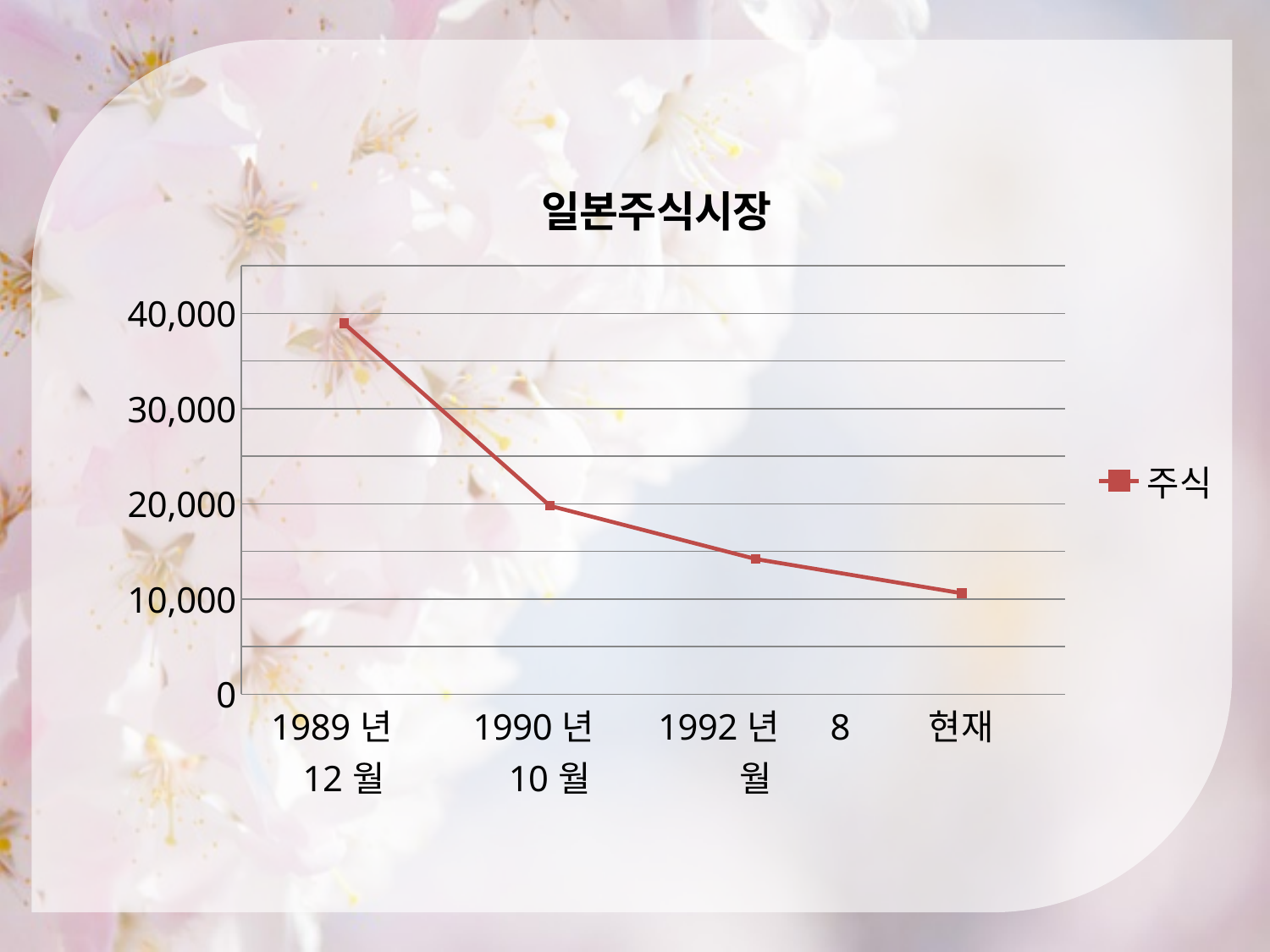
What is the title of the chart? 일본주식시장 Do the values rise or fall from 1989년 12월 to 현재? fall Which category has the lowest value? 현재 What is the name of the series shown in the legend? 주식 Is the value for 1989년 12월 greater or less than 30,000? greater How many series does the legend list? 1 Which category has the highest value? 1989년 12월 How many data points are plotted on the line? 4 Is the value for 1992년 8월 greater or less than 20,000? less What kind of chart is shown on the slide? line chart Is the value for 현재 greater or less than 20,000? less Which is larger, the value for 1990년 10월 or the value for 1992년 8월? 1990년 10월